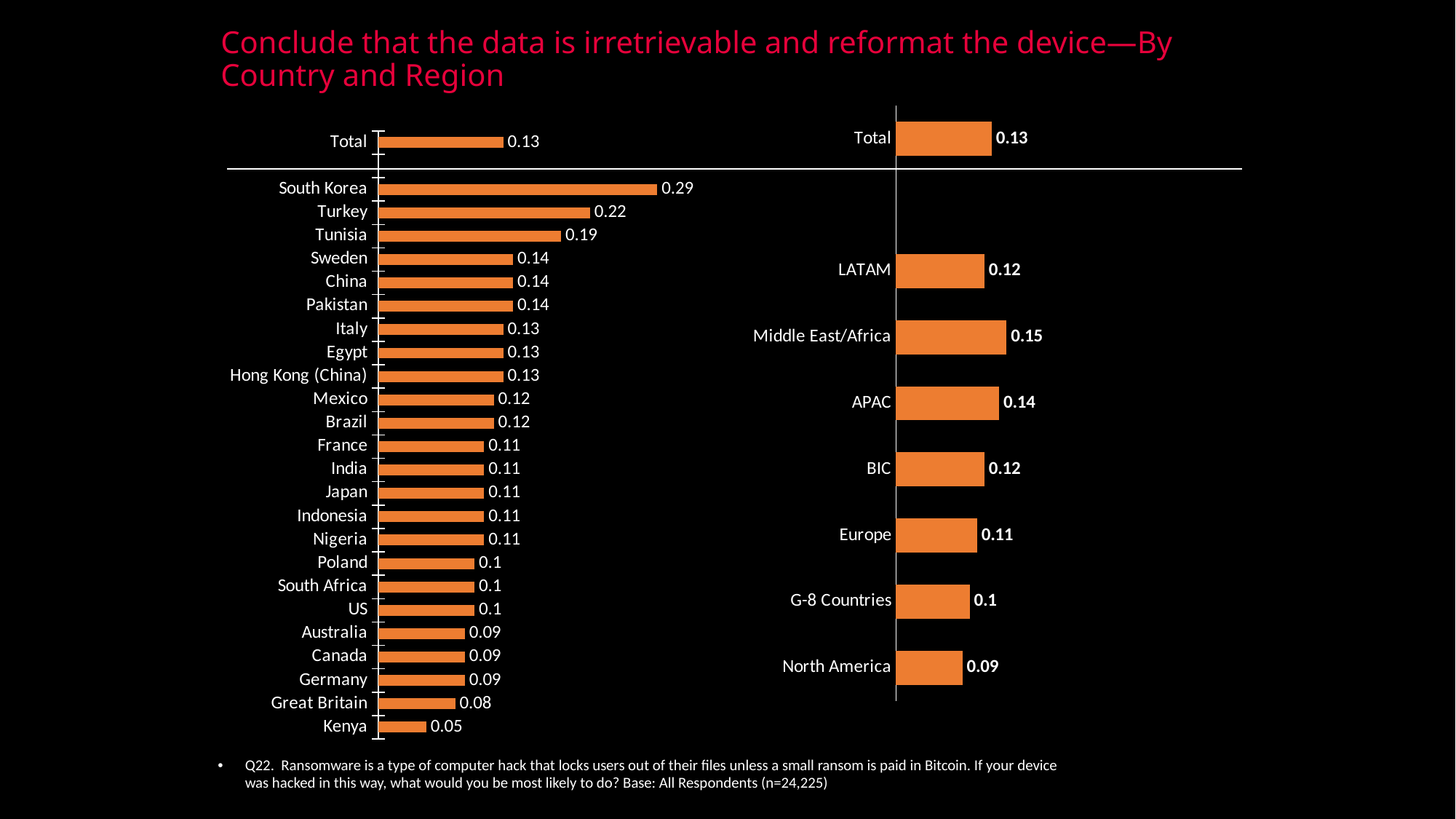
In the left chart (by country), how many countries are listed below the Total bar? 24 In the left chart (by country), what is the value for South Korea? 0.29 In the right chart (by region), what is the value for Middle East/Africa? 0.15 In the left chart (by country), what is the difference between the values for Turkey and Tunisia? 0.03 In the left chart (by country), which country has the highest value? South Korea In the right chart (by region), which region has the lowest value? North America In the left chart (by country), which country has the lowest value? Kenya In the right chart (by region), which region has the highest value? Middle East/Africa In the left chart (by country), which has the larger value, Mexico or Great Britain? Mexico In the right chart (by region), what is the difference between the values for APAC and Europe? 0.03 What type of chart is the right chart (by region)? Bar chart In the left chart (by country), what is the value for Kenya? 0.05